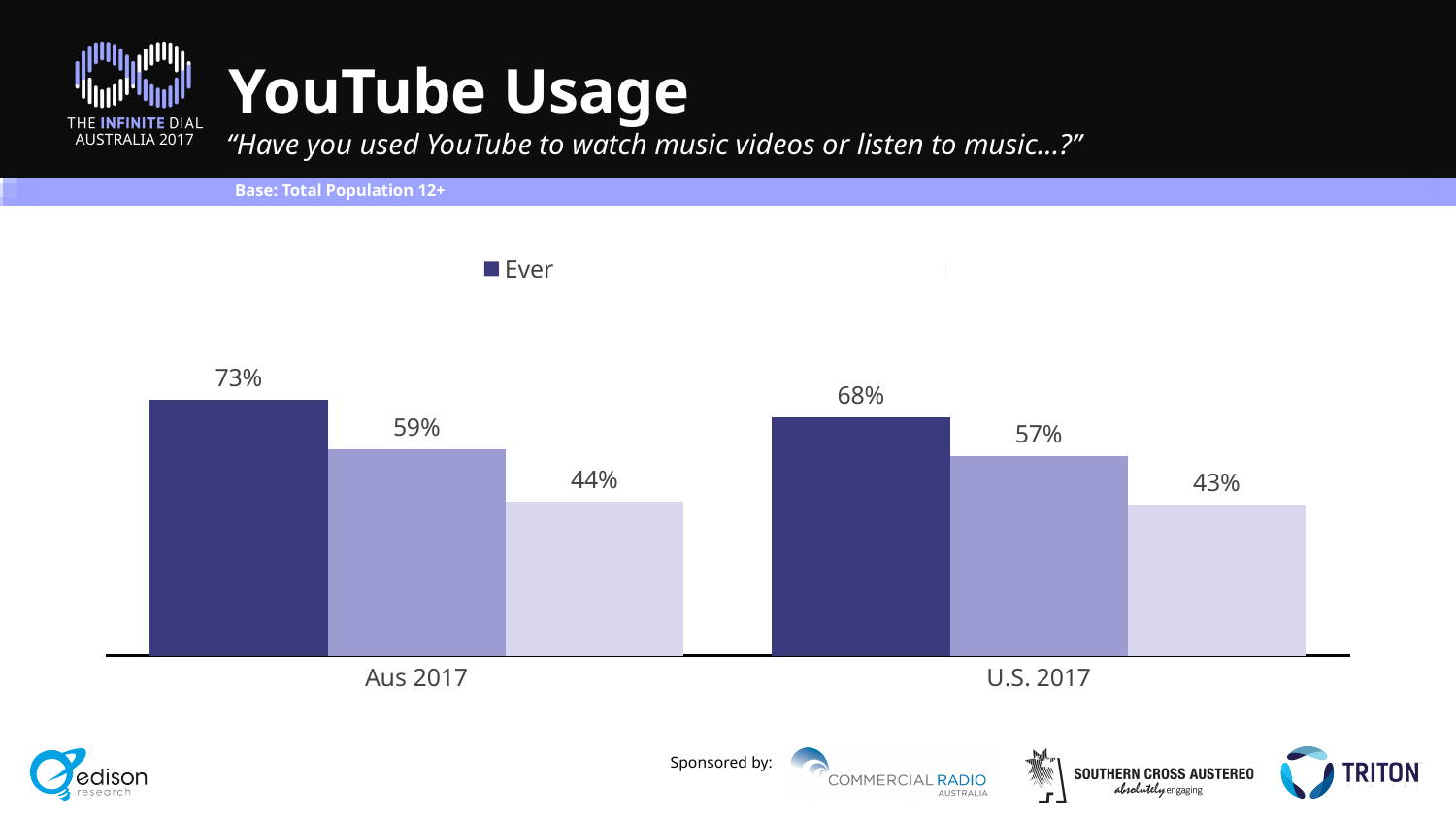
What base population is stated for the chart? Total Population 12+ What is the title of the chart on the slide? YouTube Usage What is the difference between the lightest bars for Aus 2017 and U.S. 2017? 1% What kind of chart is shown on the slide? Bar chart How many categories are shown on the x axis? 2 What is the value for "Ever" for Aus 2017? 73% What is the value of the middle bar for Aus 2017? 59% What is the value of the lightest bar for U.S. 2017? 43% Which bar has the lowest value on the chart? The lightest bar for U.S. 2017 (43%) Which category has the higher "Ever" value, Aus 2017 or U.S. 2017? Aus 2017 What is the difference between the "Ever" values for Aus 2017 and U.S. 2017? 5% What is the value for "Ever" for U.S. 2017? 68%